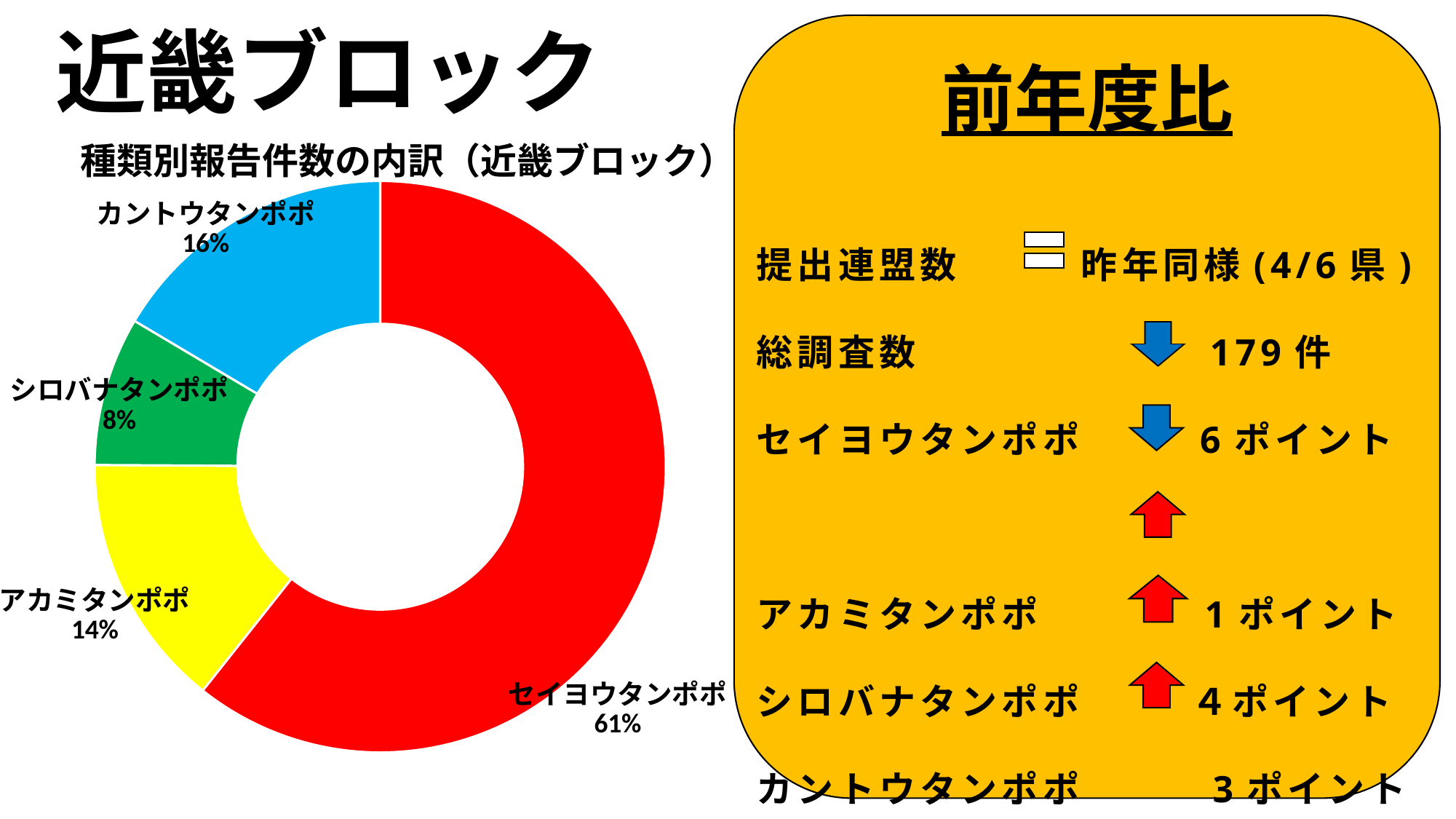
What is the title of the chart? 種類別報告件数の内訳（近畿ブロック） Which category has the smallest share of the chart? シロバナタンポポ What colour is the slice for セイヨウタンポポ? red What is the value shown for アカミタンポポ? 14% Which category has the largest share of the chart? セイヨウタンポポ What share of the chart does セイヨウタンポポ account for? 61% What kind of chart is shown on the slide? doughnut chart What is the value shown for カントウタンポポ? 16% What is the difference in percentage points between セイヨウタンポポ and カントウタンポポ? 45 What is the value shown for シロバナタンポポ? 8% How many categories are shown in the chart? 4 Which is larger, the share for アカミタンポポ or the share for シロバナタンポポ? アカミタンポポ